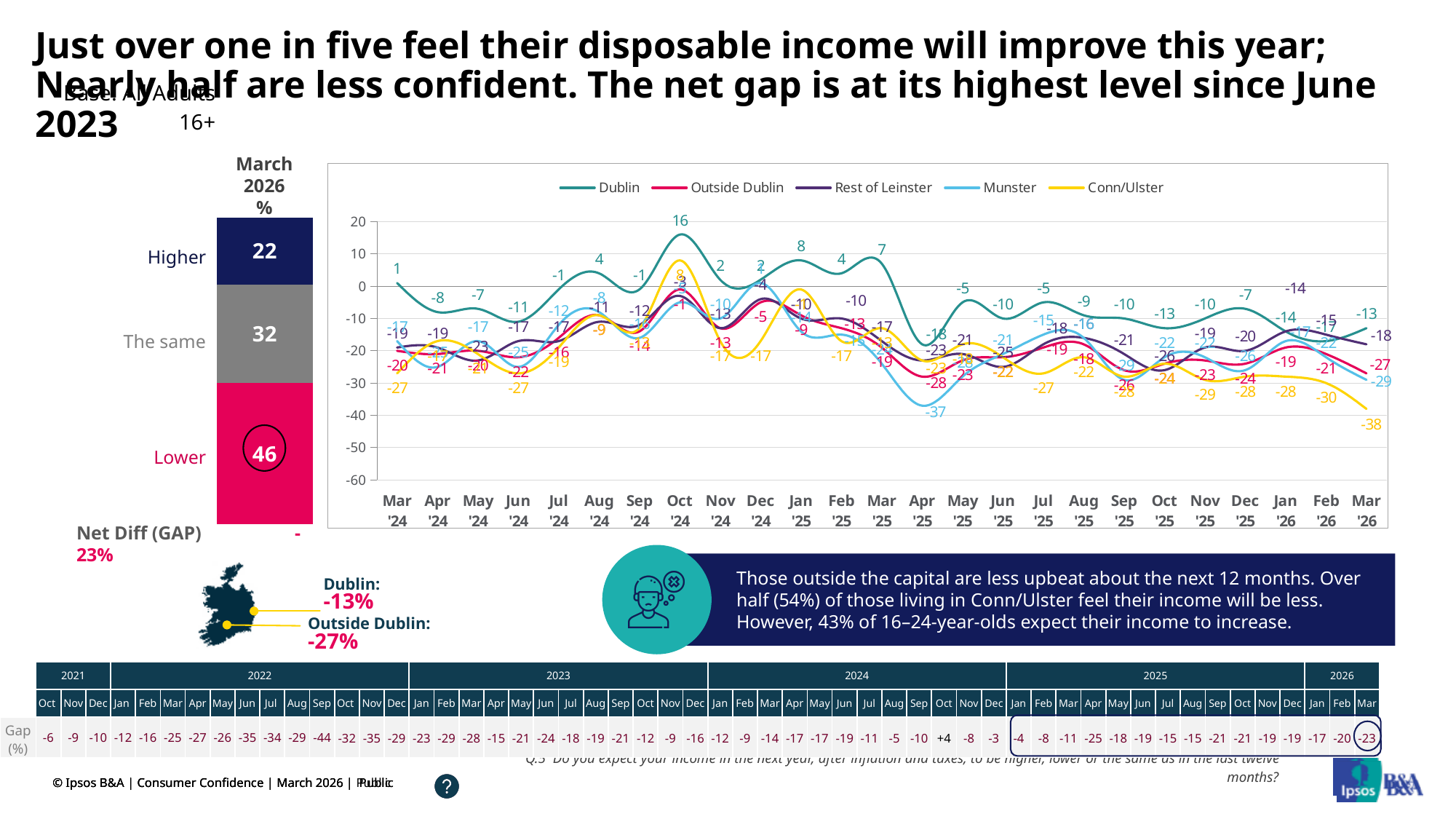
How many series does the legend of the line chart list? 5 In the line chart, which is higher in Mar '26: Dublin or Outside Dublin? Dublin In the stacked bar chart for March 2026, what is the value for Higher? 22 In the line chart, which series has the lowest value in Mar '26? Conn/Ulster What kind of chart is the large chart on the right showing regional values over time? Line chart In the stacked bar chart for March 2026, what is the value for Lower? 46 In the stacked bar chart for March 2026, which segment has the largest value? Lower In the line chart, what is the value for Dublin in Oct '24? 16 How many months are shown on the x axis of the line chart? 25 In the stacked bar chart for March 2026, what is the total of the three segments? 100 In the stacked bar chart for March 2026, what is the difference between the Lower and Higher values? 24 In the line chart, what is the value for Conn/Ulster in Mar '26? -38